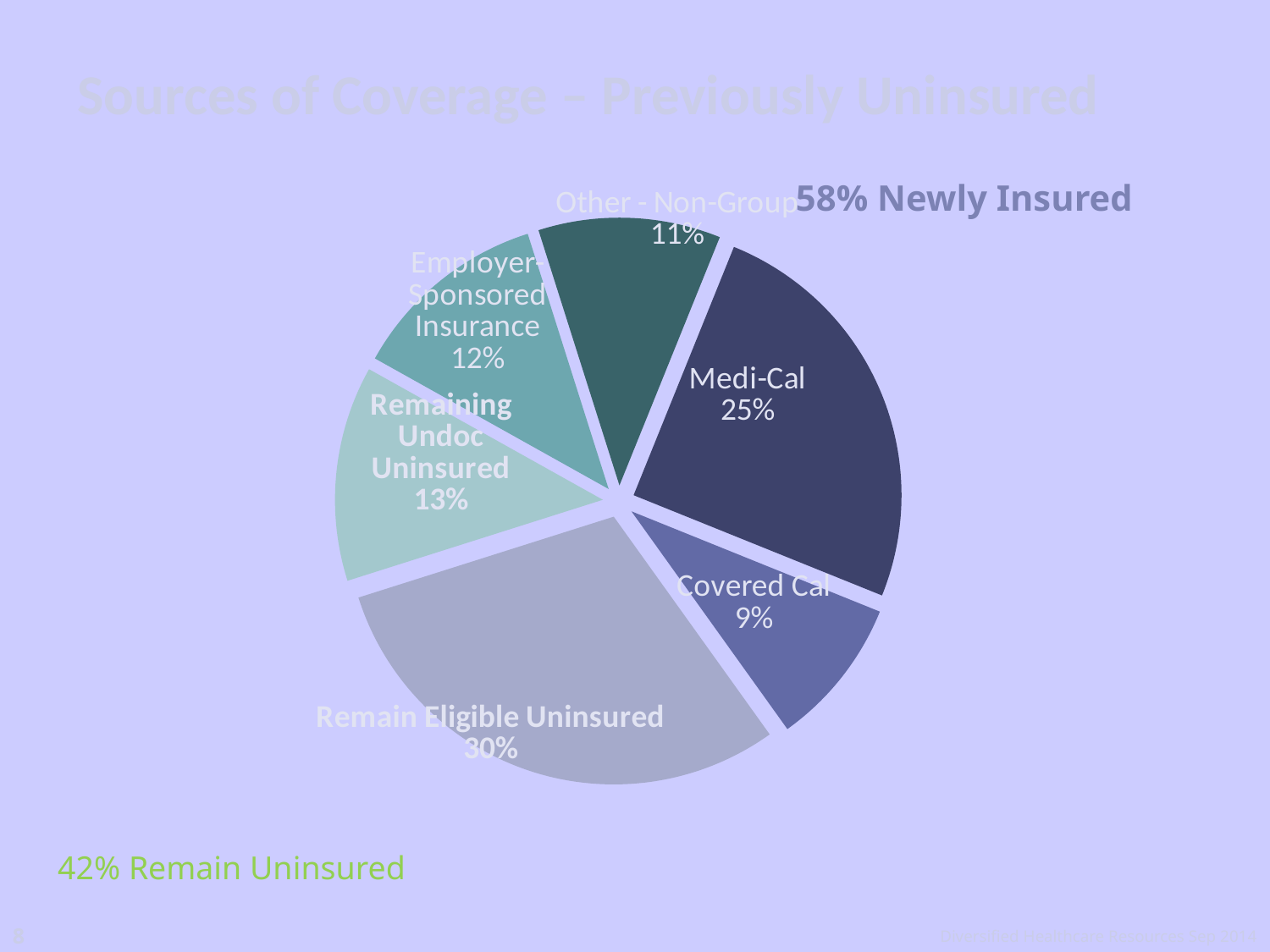
Which is larger, the Employer-Sponsored Insurance slice or the Other - Non-Group slice? Employer-Sponsored Insurance Which slice of the pie is the smallest? Covered Cal According to the annotation on the slide, what percentage are newly insured? 58% Which slice of the pie is the largest? Remain Eligible Uninsured What is the difference in percentage points between Medi-Cal and Remaining Undoc Uninsured? 12 What share of the pie does Medi-Cal represent? 25% What percentage is shown for Covered Cal? 9% What percentage is shown for Remain Eligible Uninsured? 30% What type of chart is shown on the slide? Pie chart What percentage is shown for Other - Non-Group? 11% How many slices does the pie chart have? 6 What percentage is shown for Employer-Sponsored Insurance? 12%